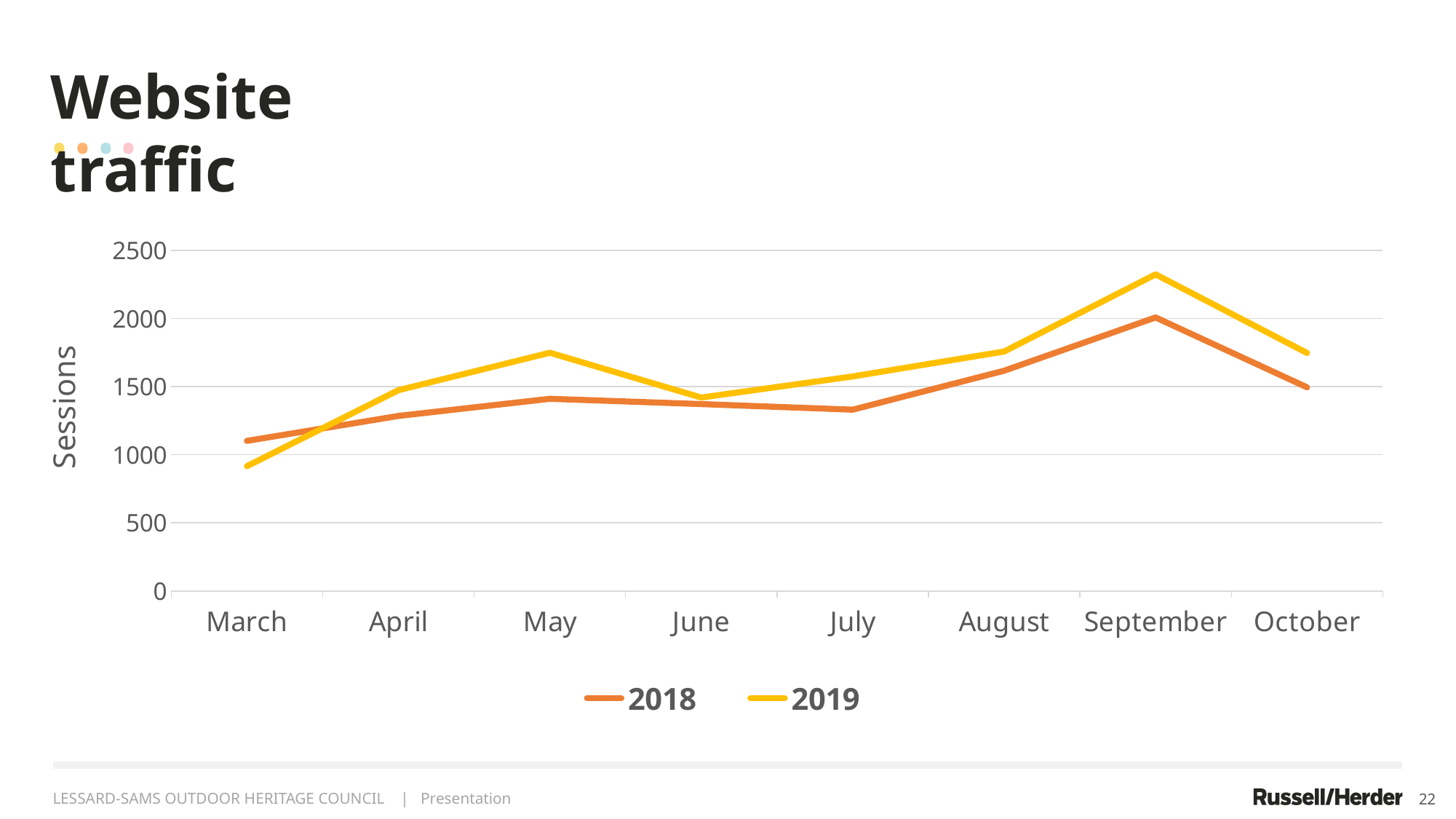
Which series has the larger value in May, 2018 or 2019? 2019 How many series does the legend list? 2 How many months are plotted along the x axis? 8 In which month does the 2019 series have its lowest value? March Is the value for 2018 in July greater or less than 1500? less In which month does the 2019 series reach its highest value? September In which month does the 2018 series reach its highest value? September Is the value for 2019 in March greater or less than 1000? less What kind of chart is shown on the slide? line chart Is the value for 2019 in September greater or less than 2000? greater What is the label on the y axis? Sessions Which series has the larger value in March, 2018 or 2019? 2018